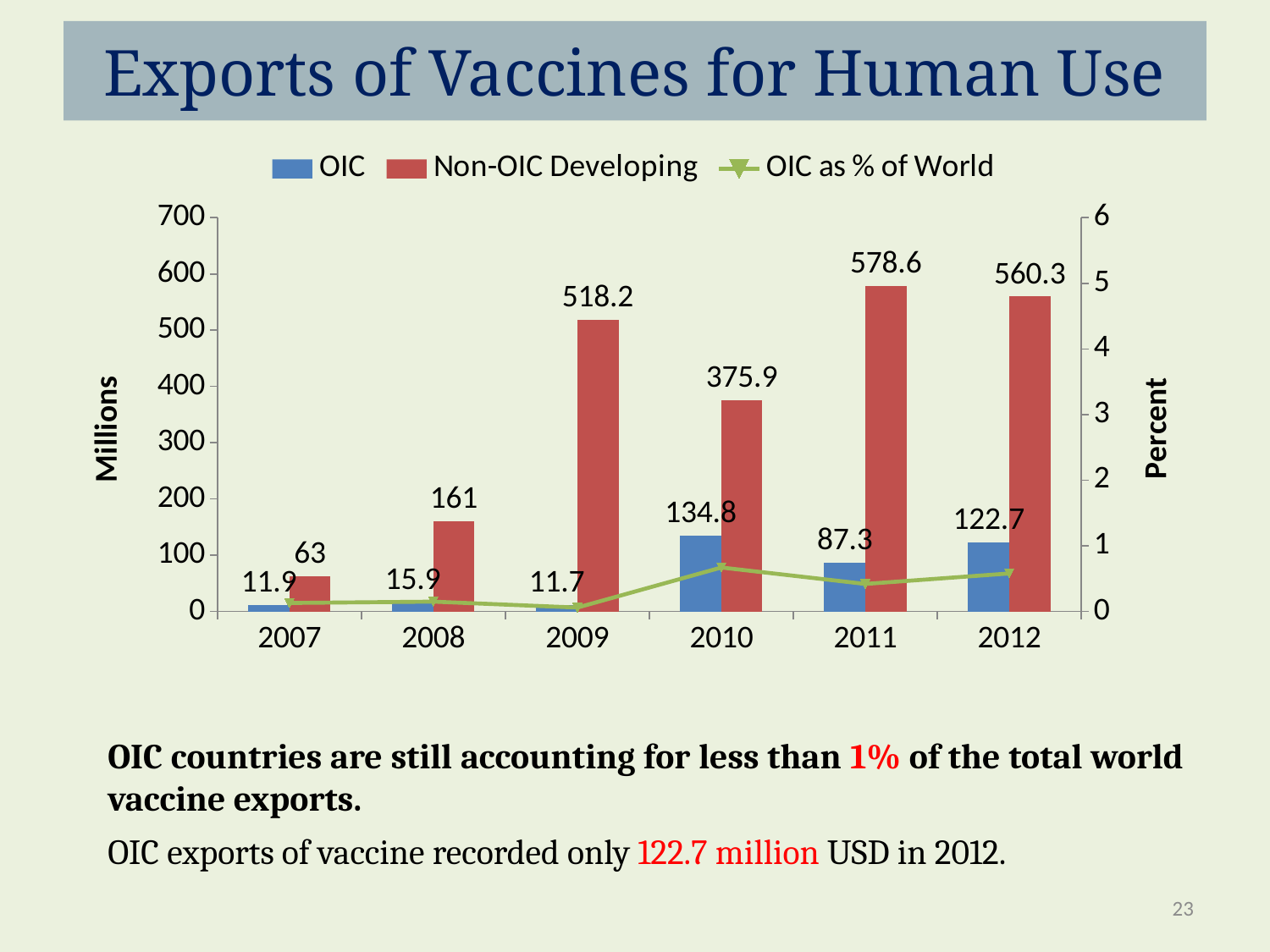
How many years are shown on the x axis? 6 Which is larger, the OIC value in 2010 or the OIC value in 2011? 2010 In which year is the OIC value lowest? 2009 What is the value for Non-OIC Developing in 2008? 161 In which year is the Non-OIC Developing value highest? 2011 Does the Non-OIC Developing value rise or fall from 2007 to 2009? rise What is the value for OIC in 2010? 134.8 What is the difference between the Non-OIC Developing and OIC values in 2012? 437.6 What is the label of the right-hand vertical axis? Percent How many series does the legend list? 3 What is the value for Non-OIC Developing in 2011? 578.6 Is the OIC as % of World value in 2010 greater or less than 1? less